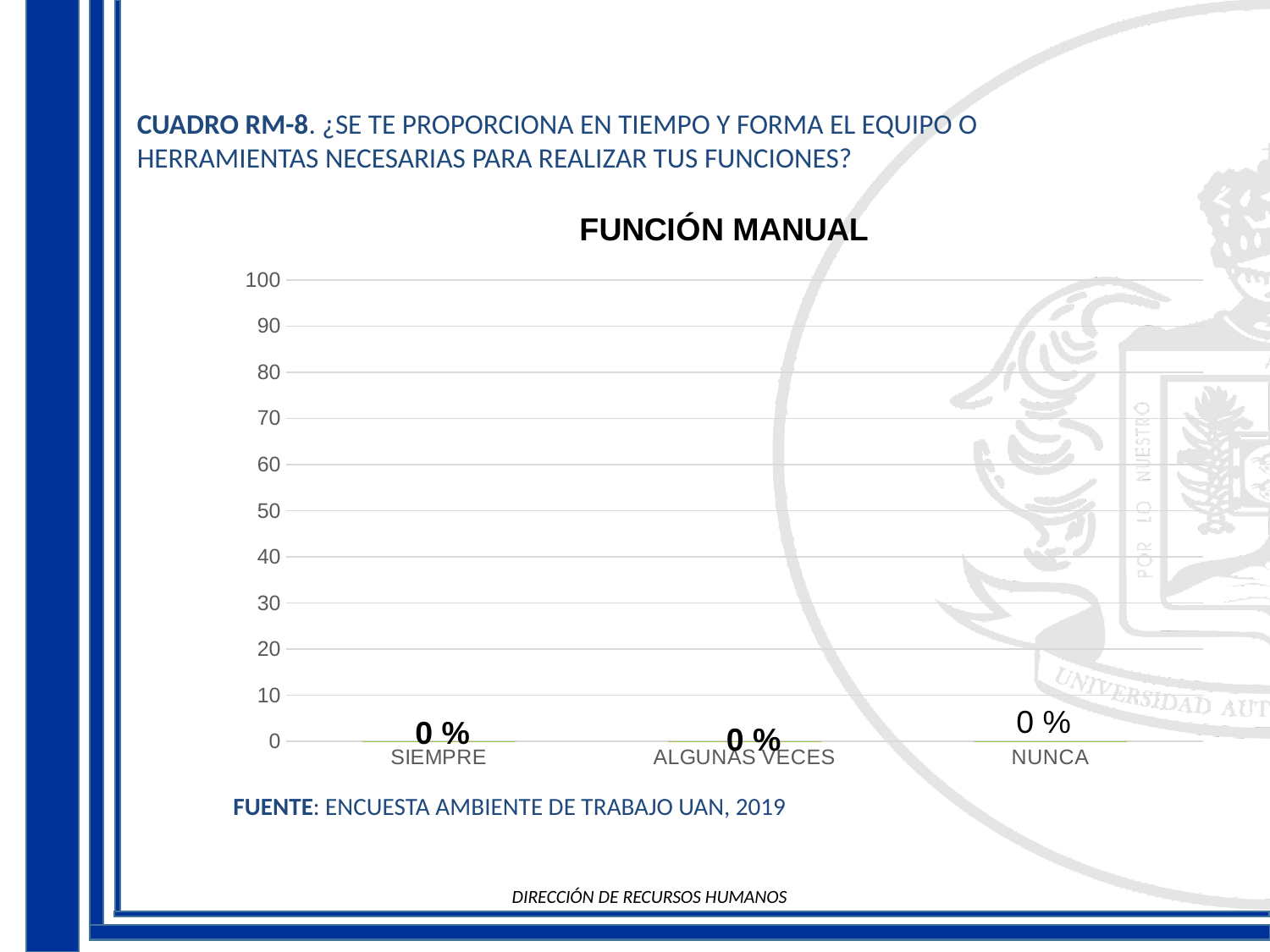
What is the difference between the values for SIEMPRE and NUNCA? 0 % What is the value for NUNCA in the FUNCIÓN MANUAL chart? 0 % Is the value for NUNCA greater or less than 10? less How many categories are shown on the x axis of the chart? 3 What is the highest value shown on the y axis of the chart? 100 What is the title of the chart? FUNCIÓN MANUAL What kind of chart is shown on the slide? bar chart What is the value for SIEMPRE in the FUNCIÓN MANUAL chart? 0 % What is the value for ALGUNAS VECES in the FUNCIÓN MANUAL chart? 0 % Do the values rise or fall from SIEMPRE to NUNCA along the x axis? neither; all values are 0 % Is the value for SIEMPRE greater or less than 50? less